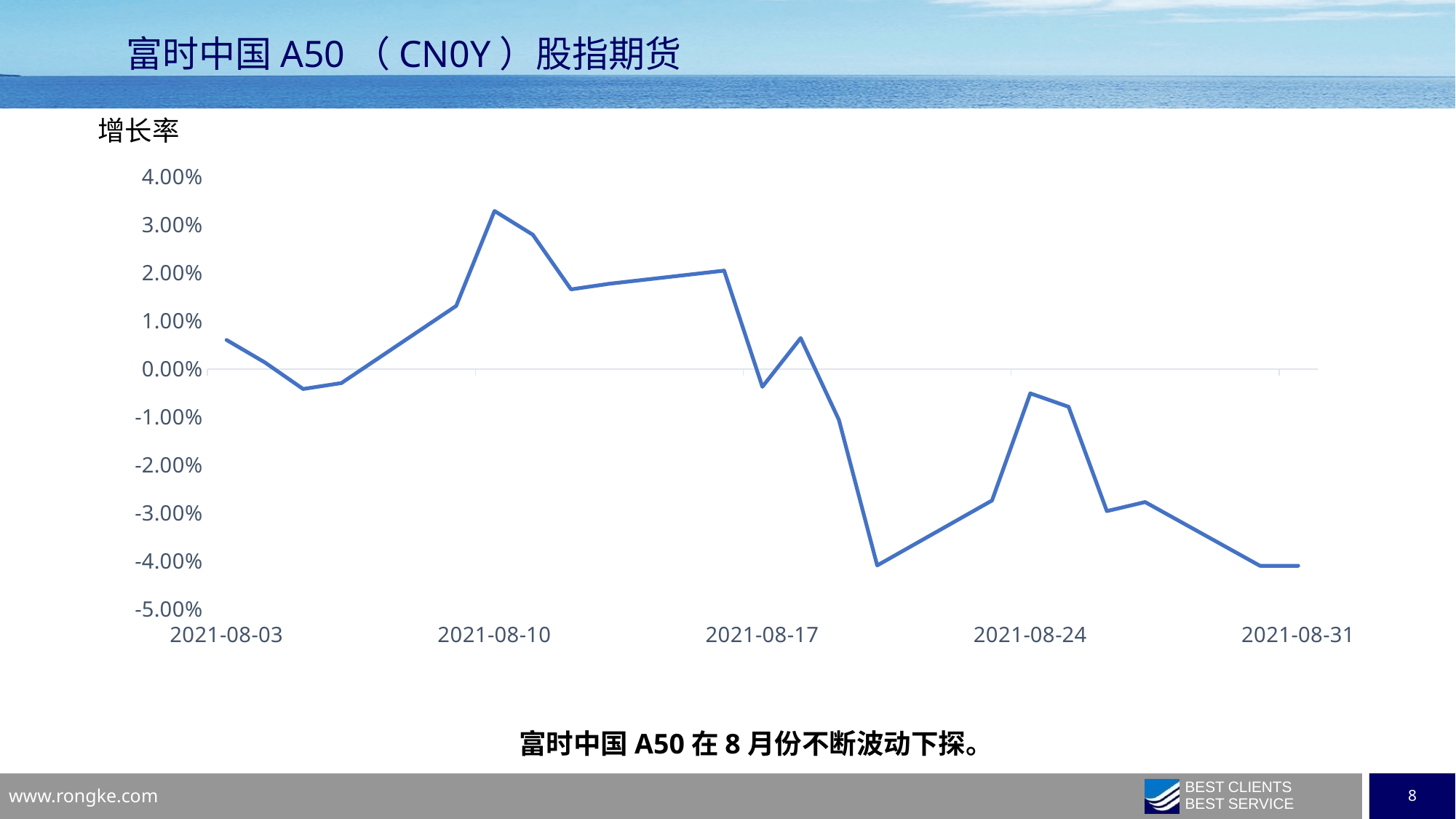
Is the value for 2021-08-17 greater or less than 1.00%? less Is the value for 2021-08-10 greater or less than 3.00%? greater How many date labels are shown on the x axis? 5 Is the value for 2021-08-31 greater or less than -3.00%? less What label is shown on the vertical axis of the chart? 增长率 How many data series are plotted in the chart? 1 Overall, do the values rise or fall from 2021-08-03 to 2021-08-31? fall What is the title of the slide's chart? 富时中国 A50 （CN0Y） 股指期货 What kind of chart is shown on the slide? line chart Which of the labelled dates has the highest value on the chart? 2021-08-10